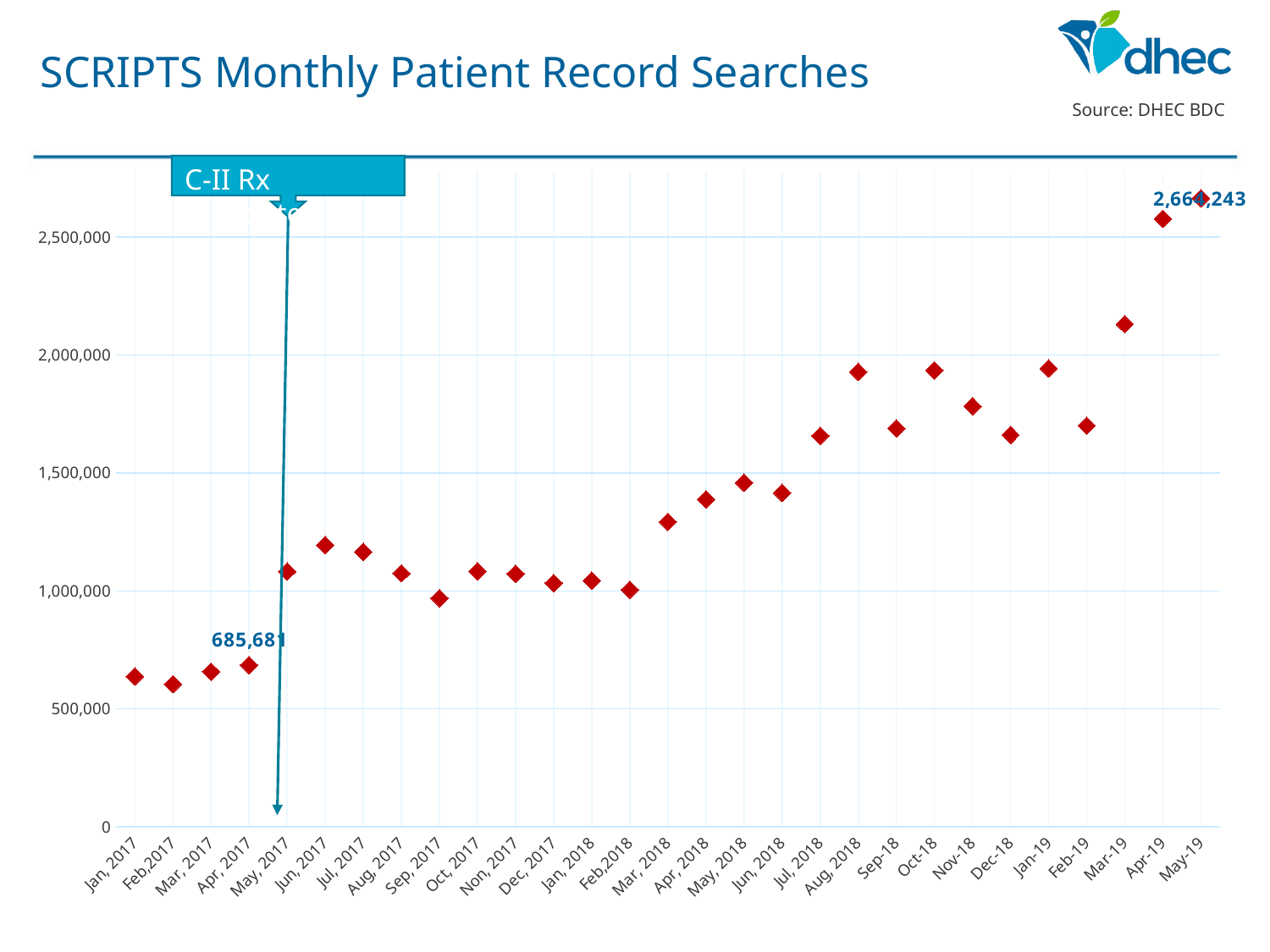
Which is larger, the value for Apr-19 or the value for Mar-19? Apr-19 Is the value for Jan, 2017 greater or less than 500,000? greater What is the value for Apr, 2017? 685,681 Is the value for Mar-19 greater or less than 2,000,000? greater What label is shown in the callout box pointing to May, 2017? C-II Rx Do the values generally rise or fall from Jan, 2017 to May-19? rise Which month has the lowest number of patient record searches? Feb, 2017 Which month has the highest number of patient record searches? May-19 Is the value for Aug, 2018 greater or less than 2,000,000? less What kind of chart is shown on the slide? scatter chart How many months are plotted on the chart? 29